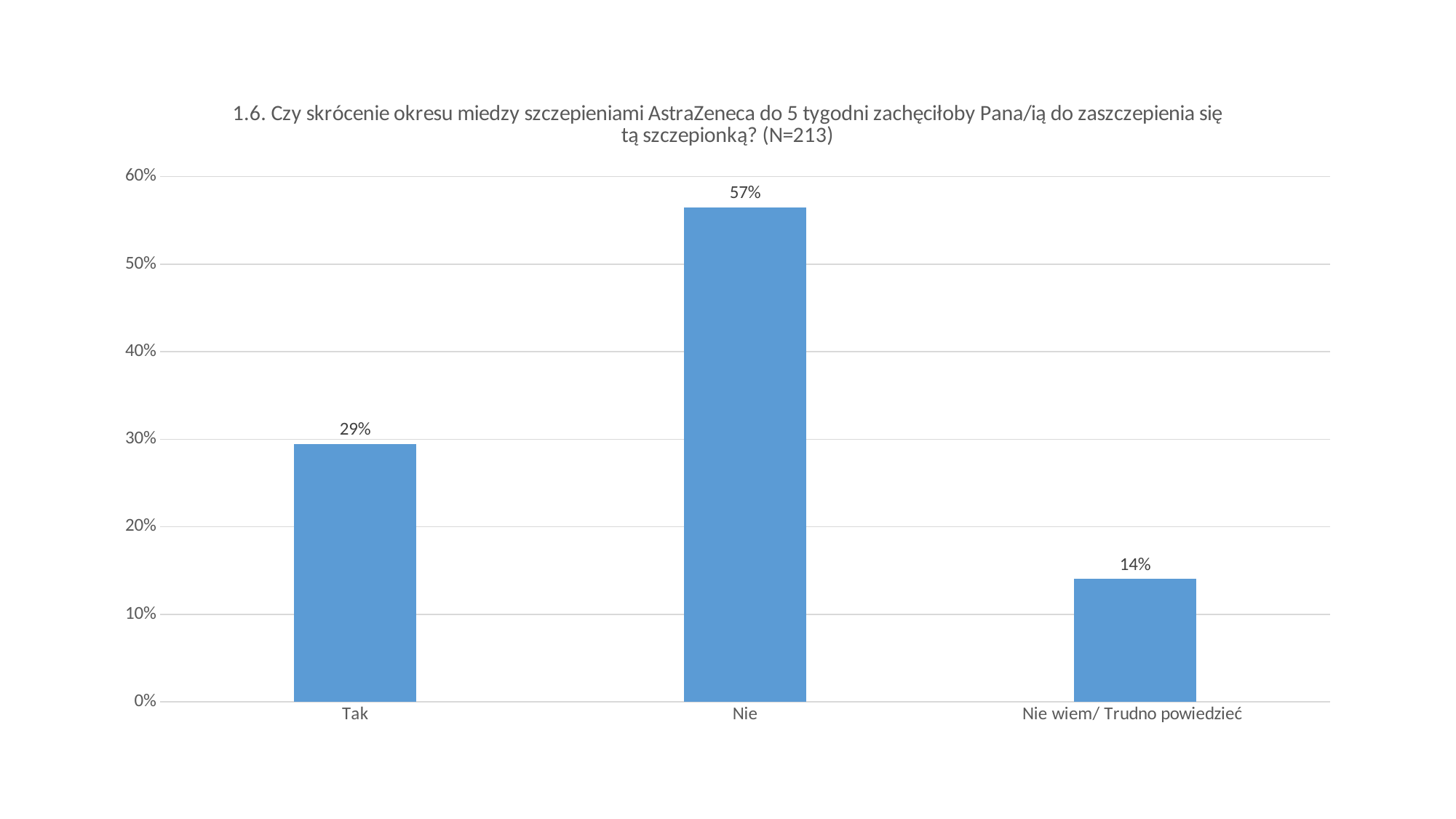
What is the difference between the values for "Tak" and "Nie wiem/ Trudno powiedzieć"? 15% Which category has the lowest value? Nie wiem/ Trudno powiedzieć Which category has the highest value? Nie Which is larger, the value for "Tak" or the value for "Nie"? Nie What is the value for "Tak"? 29% What is the value for "Nie wiem/ Trudno powiedzieć"? 14% How many categories are shown on the x axis? 3 What kind of chart is shown on the slide? bar chart What is the difference between the values for "Nie" and "Tak"? 28% What sample size (N) is stated in the chart title? N=213 Is the value for "Nie" greater or less than 50%? greater What is the value for "Nie"? 57%